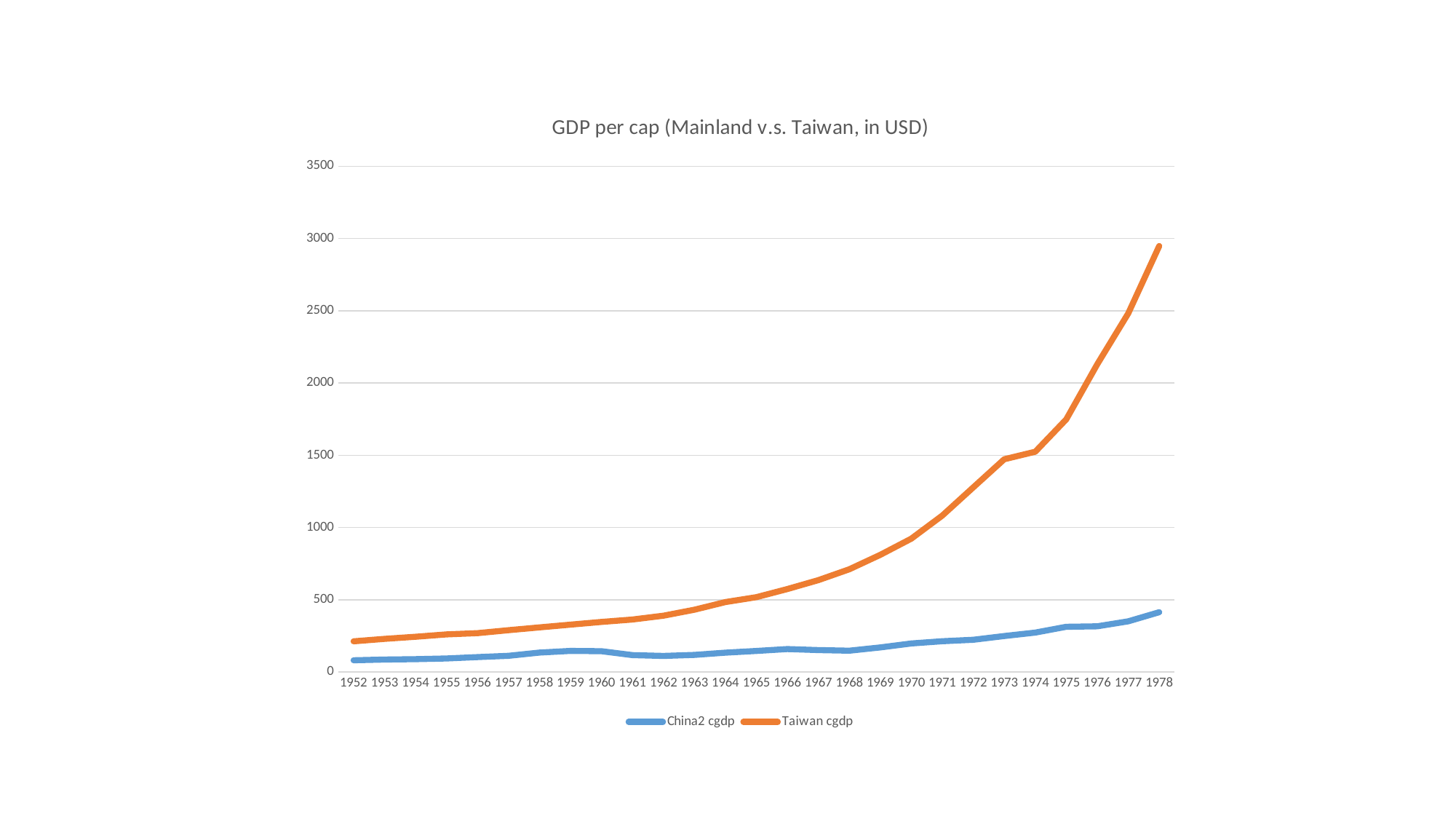
Is the value for China2 cgdp in 1978 greater or less than 500? less Is the value for Taiwan cgdp in 1973 greater or less than 1000? greater Which series has the higher value in 1978? Taiwan cgdp Is the value for Taiwan cgdp in 1970 greater or less than 1000? less In which year does the Taiwan cgdp series reach its highest value? 1978 How many years are shown on the x axis? 27 What type of chart is shown on the slide? line chart How many series does the legend list? 2 Does the Taiwan cgdp series generally rise or fall from 1952 to 1978? rise Which series is drawn in orange? Taiwan cgdp What is the title of the chart? GDP per cap (Mainland v.s. Taiwan, in USD)